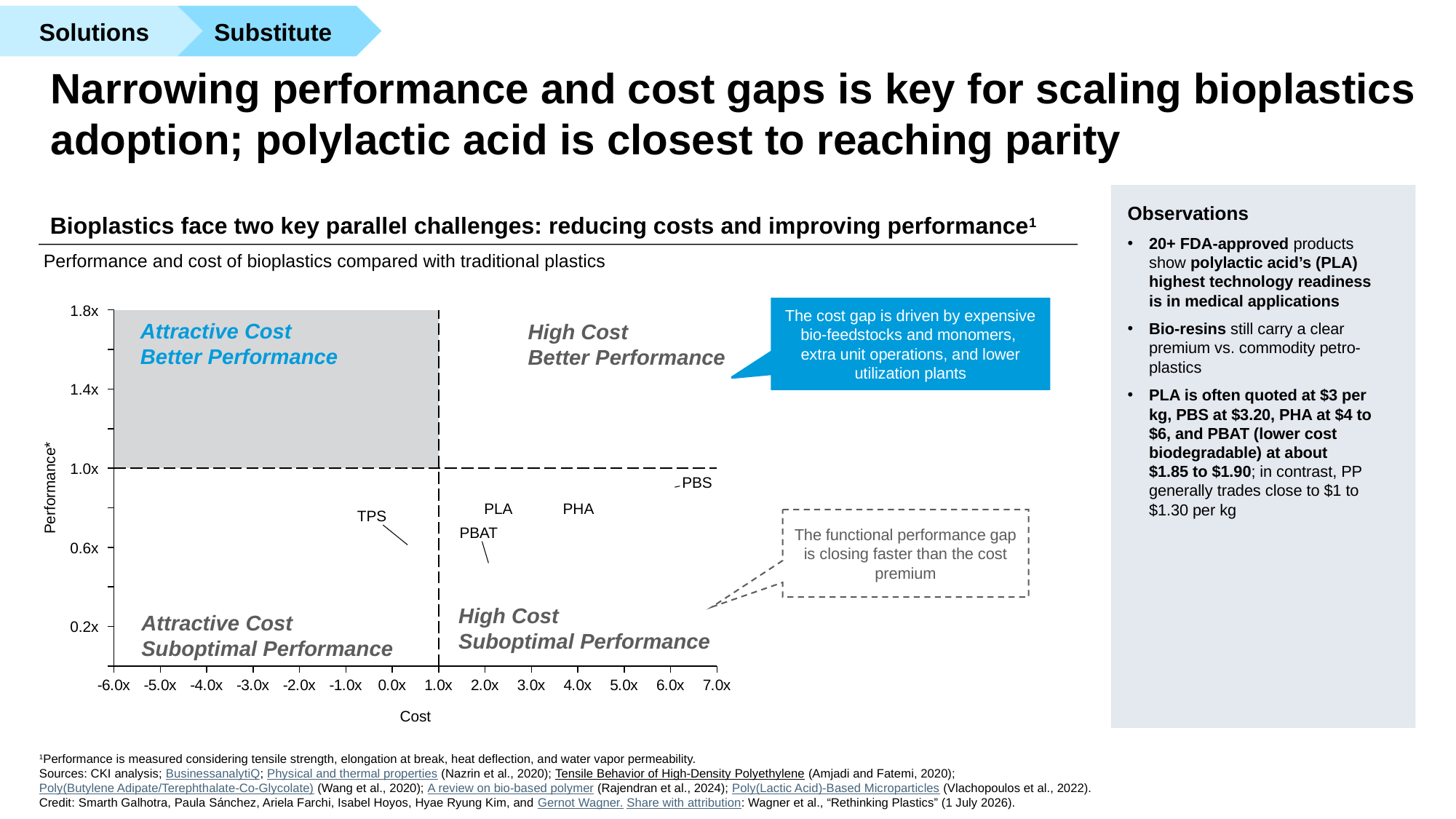
Which bioplastic has the highest cost on the chart? PBS How many bioplastics are plotted as points on the chart? 5 Which has the higher performance, PBS or PBAT? PBS Is the performance value for PBAT greater or less than 1.0x? less Which bioplastic has the highest performance on the chart? PBS Is the cost value for PBS greater or less than 5.0x? greater Is the cost value for TPS greater or less than 0.0x? greater What kind of chart is shown on the slide? scatter chart What is the label of the x axis of the chart? Cost Which bioplastic has the lowest cost on the chart? TPS Which has the higher cost, TPS or PHA? PHA